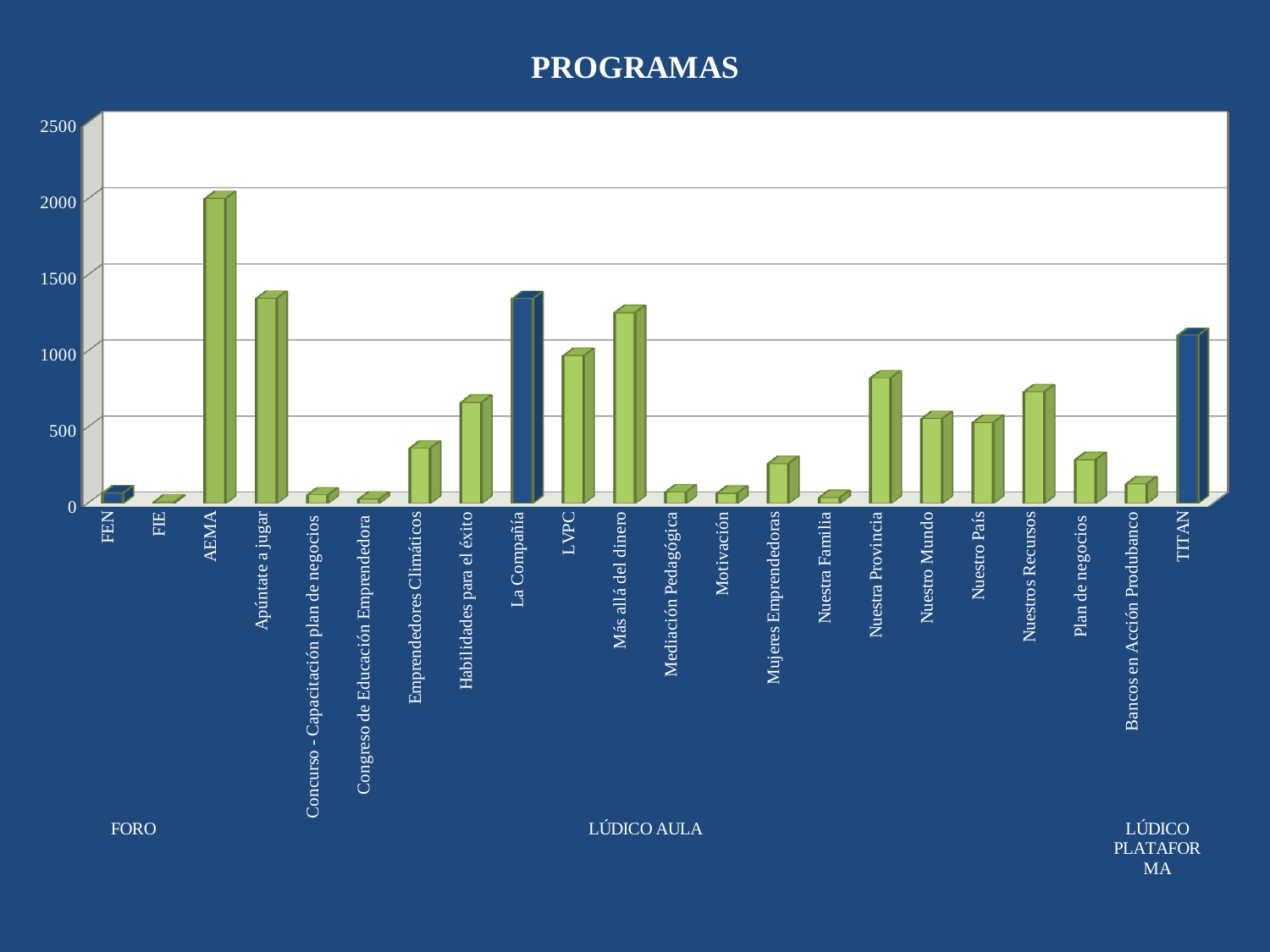
What kind of chart is shown on the slide? bar chart Is the value for AEMA greater or less than 1500? greater Which category has the highest value in the chart? AEMA How many categories are shown on the x axis of the chart? 22 Is the value for Nuestra Provincia greater or less than 500? greater Which is larger, the value for Más allá del dinero or the value for Nuestra Provincia? Más allá del dinero Which is larger, the value for Habilidades para el éxito or the value for Mujeres Emprendedoras? Habilidades para el éxito What is the title of the chart? PROGRAMAS Is the value for Apúntate a jugar greater or less than 1000? greater Which is larger, the value for La Compañía or the value for LVPC? La Compañía